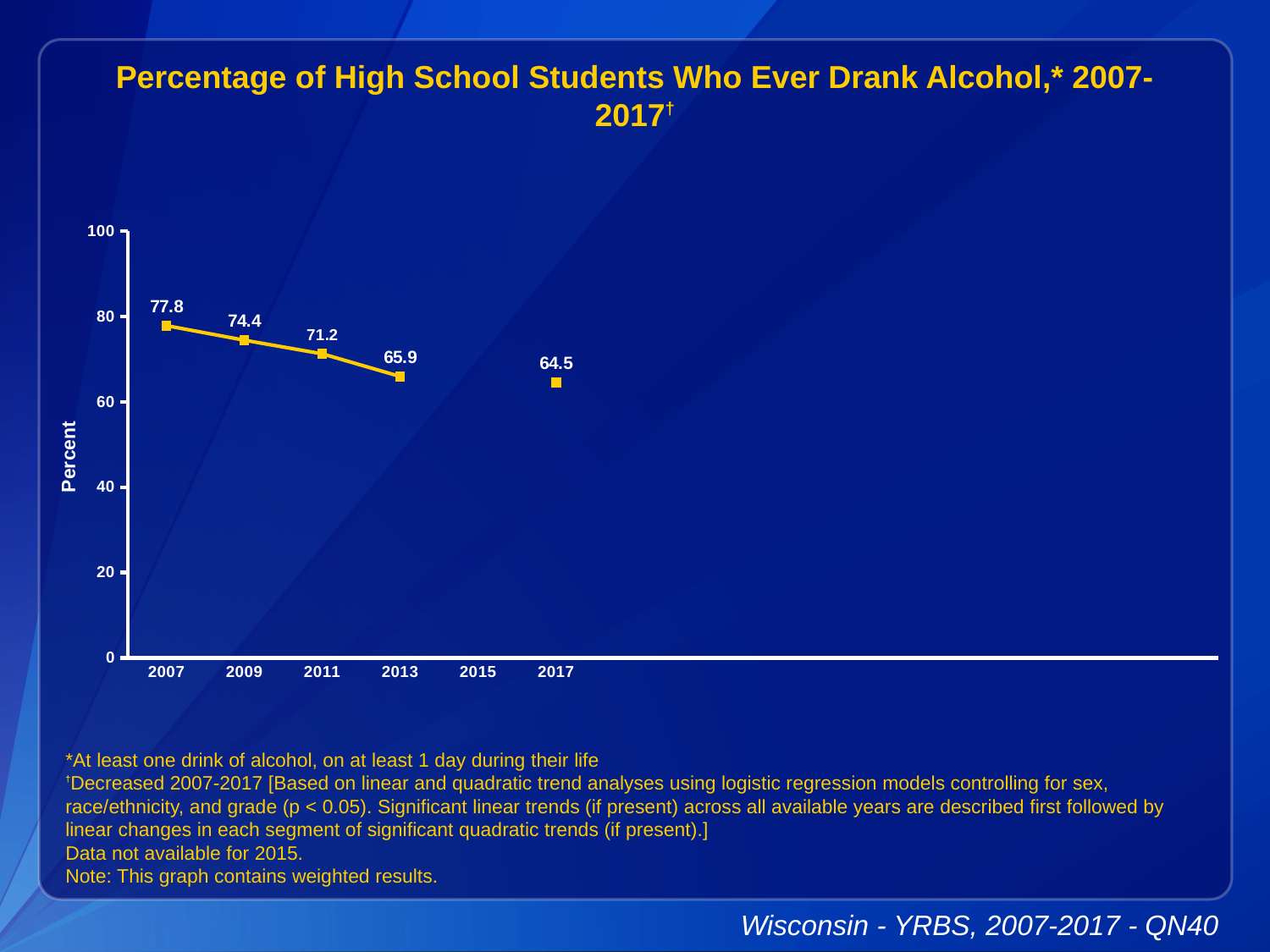
What is the value for 2017? 64.5 What kind of chart is this? line chart Do the values rise or fall from 2007 to 2017? fall Which is larger, the value for 2011 or the value for 2013? 2011 What is the difference between the values for 2007 and 2017? 13.3 What is the value for 2007? 77.8 How many years have a plotted data point? 5 What is the label on the y axis? Percent What is the difference between the values for 2009 and 2011? 3.2 What is the value for 2013? 65.9 Which year has the lowest plotted value? 2017 Which year has the highest value? 2007